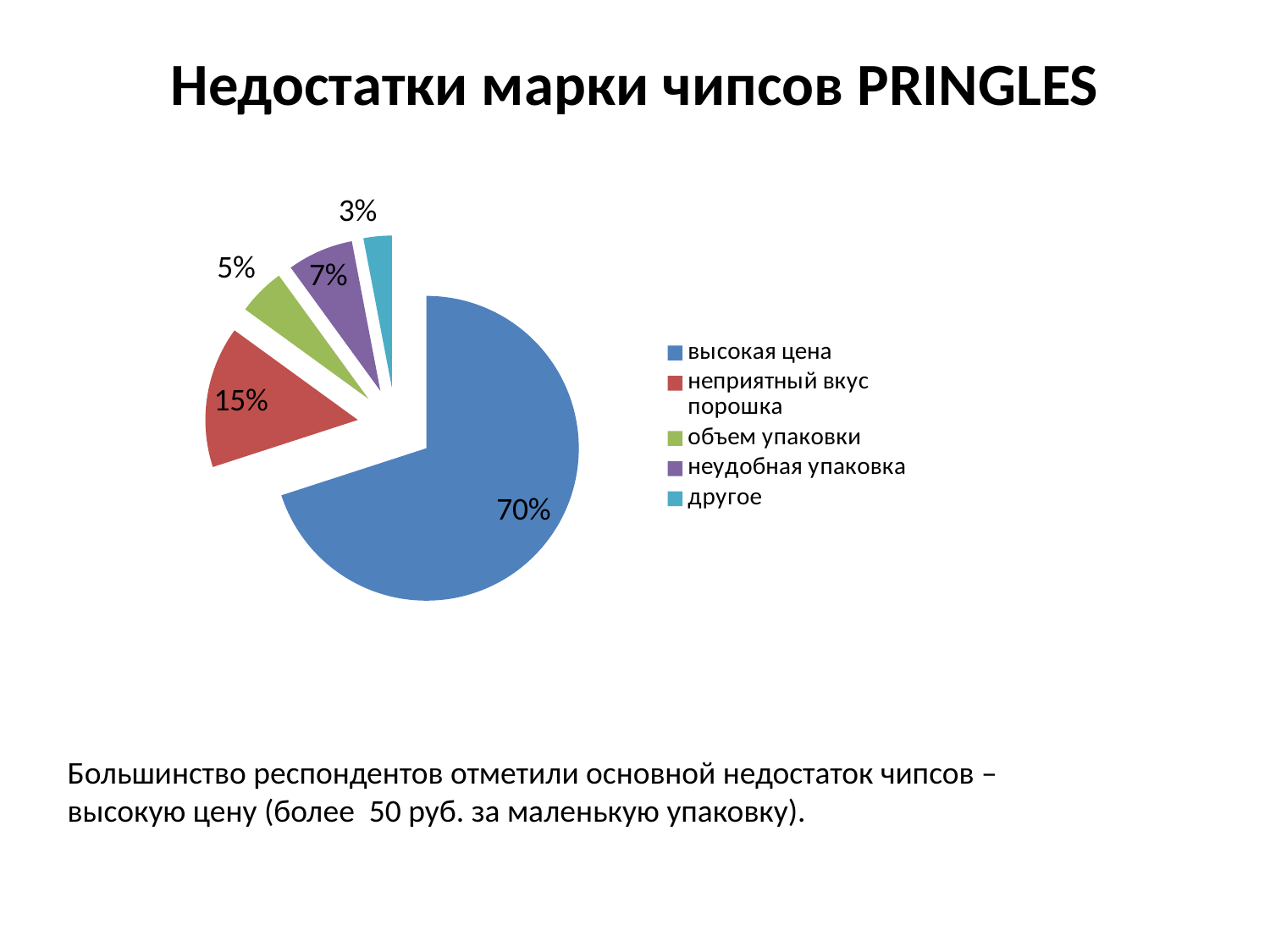
What share of the pie does "высокая цена" take? 70% What is the value for "неприятный вкус порошка"? 15% Which is larger, "неудобная упаковка" or "объем упаковки"? неудобная упаковка What is the title of the slide? Недостатки марки чипсов PRINGLES How many categories are shown in the pie chart? 5 Which category has the largest slice? высокая цена What is the value for "объем упаковки"? 5% What is the value for "другое"? 3% What is the value for "неудобная упаковка"? 7% What kind of chart is shown on the slide? pie chart What is the difference between the values for "высокая цена" and "неприятный вкус порошка"? 55% Which category has the smallest slice? другое